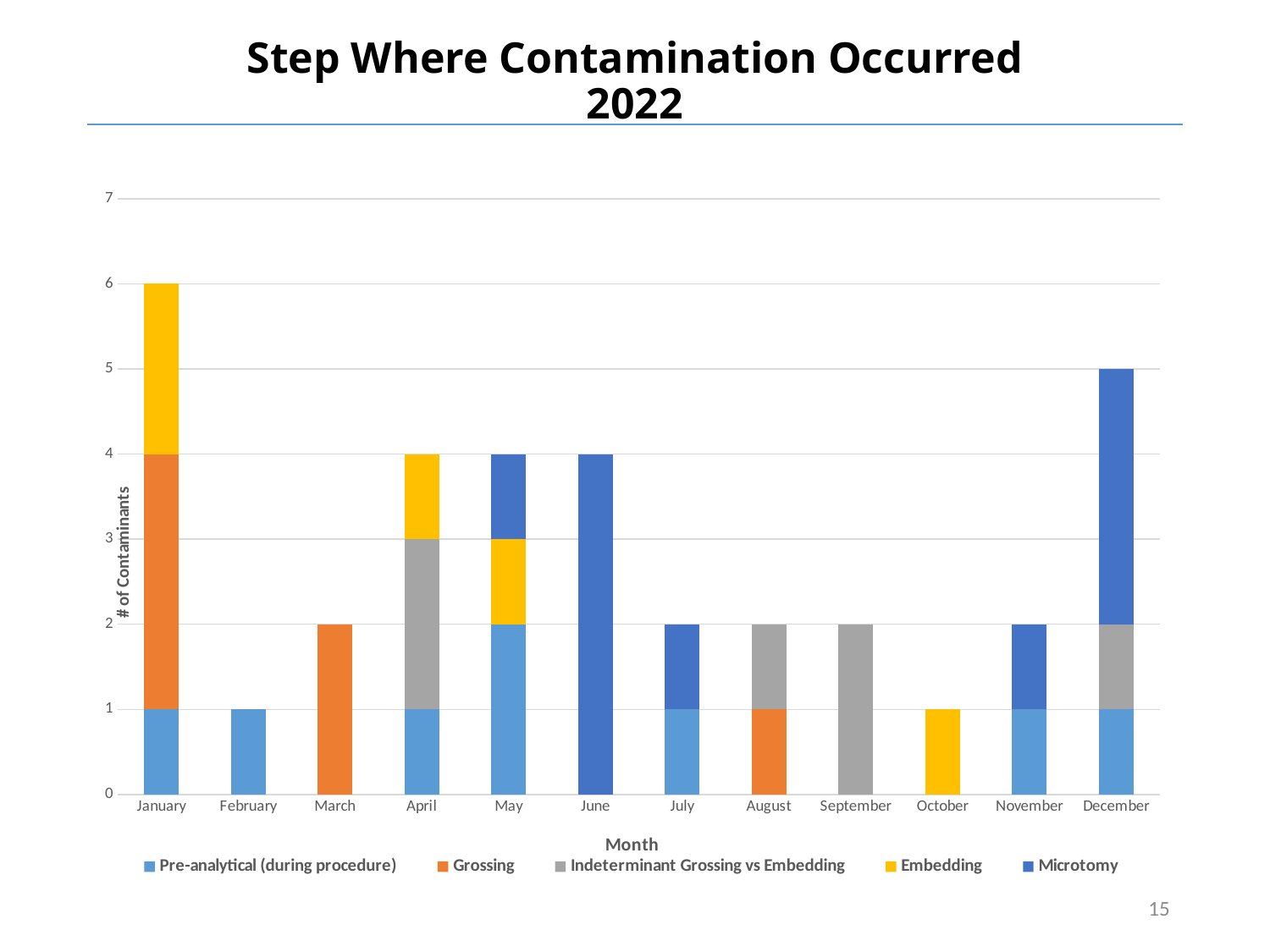
Is the total value for December greater or less than 4? greater What is the total number of contaminants for December? 5 What is the total number of contaminants for January? 6 What is the value of the Pre-analytical (during procedure) series for February? 1 How many months are shown along the x axis? 12 What is the total number of contaminants for June? 4 Which month has a higher total number of contaminants, February or March? March What is the difference between the total contaminants in January and in December? 1 How many series does the legend list? 5 What colour represents the Embedding series in the legend? Yellow Which month has the highest total number of contaminants? January What kind of chart is shown on the slide? Stacked bar chart